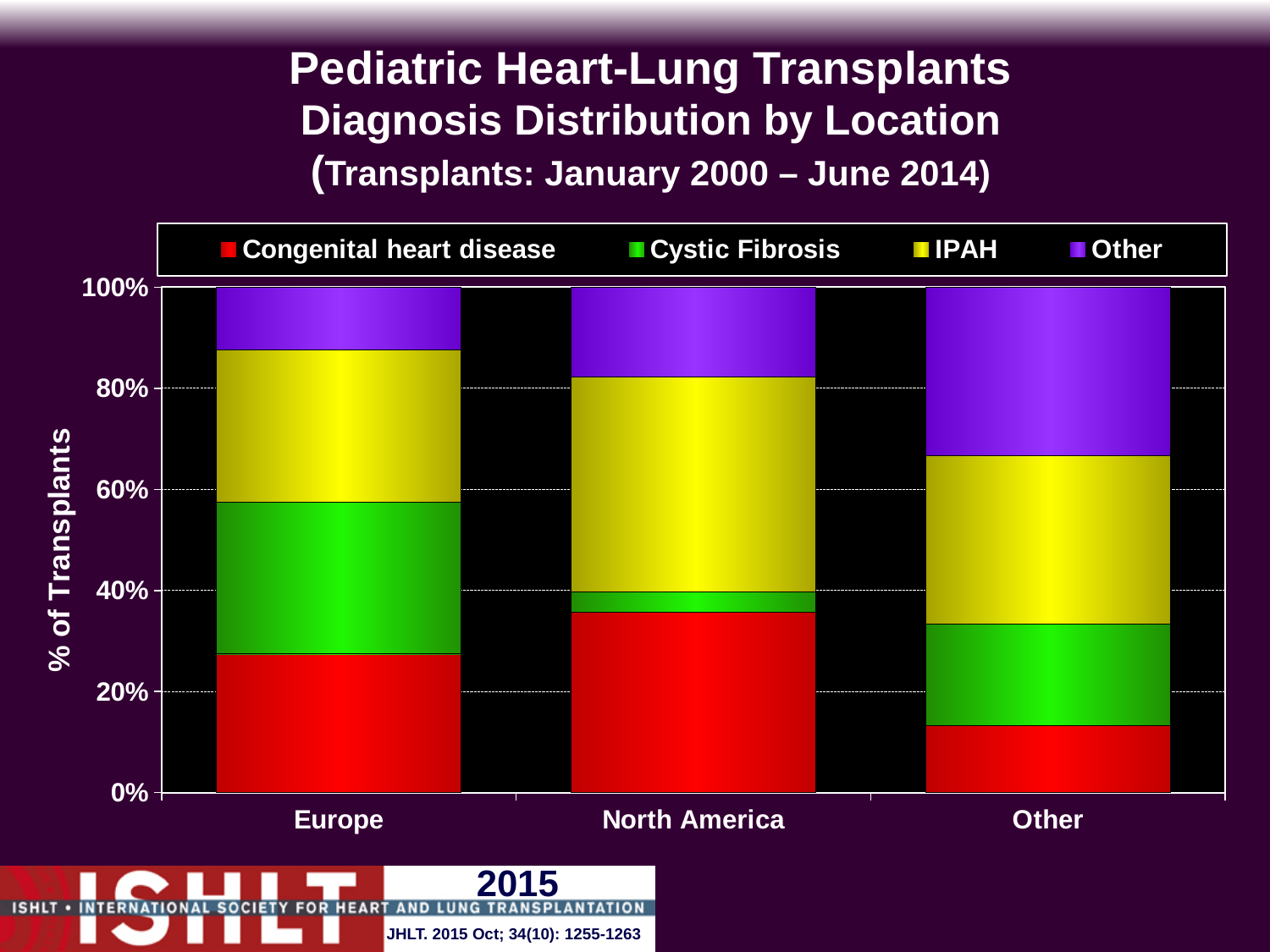
Is the Congenital heart disease share for North America greater or less than 40%? less Which location has the largest share of the 'Other' diagnosis category? Other What kind of chart is shown on the slide? Stacked bar chart Which location has the largest share of Congenital heart disease? North America What is the label on the y axis? % of Transplants Is the Congenital heart disease share for Other greater or less than 20%? less How many diagnosis series does the legend list? 4 Is the Congenital heart disease share for Europe greater or less than 20%? greater Which location has the smallest share of Congenital heart disease? Other Which location has the largest share of Cystic Fibrosis? Europe Which location has the smallest share of Cystic Fibrosis? North America How many locations are shown on the x axis? 3